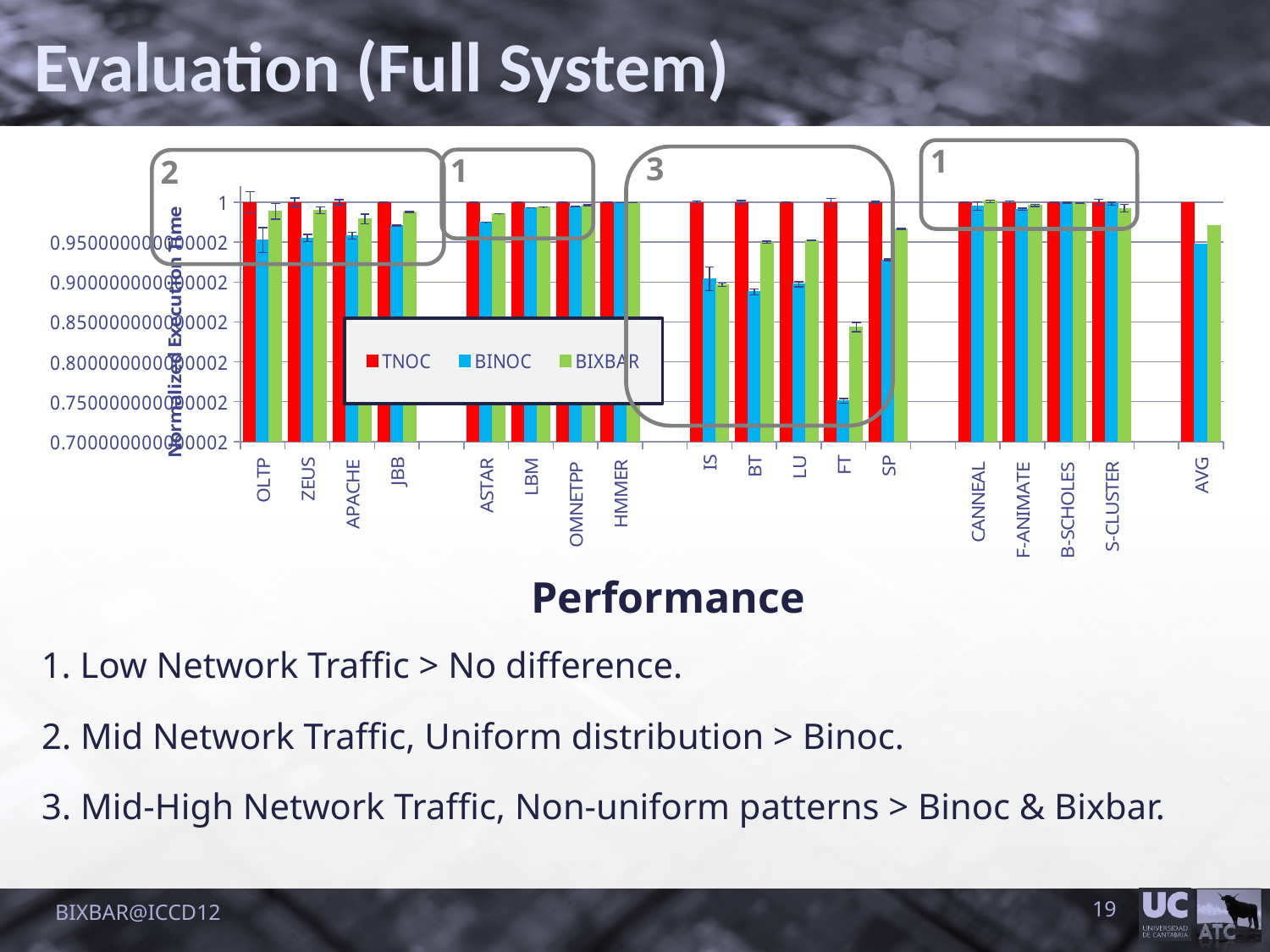
How many categories are shown along the x axis of the chart? 18 Which category has the lowest BINOC value? FT Is the BIXBAR value for FT greater or less than 0.9? less Is the BINOC value for SP greater or less than 0.95? less What is the title shown beneath the chart? Performance What are the three series named in the chart legend? TNOC, BINOC, BIXBAR What kind of chart is shown on the slide? bar chart How many series does the chart legend list? 3 Which category has the lowest BIXBAR value? FT Is the BINOC value for FT greater or less than 0.8? less For FT, which is larger: the BINOC value or the BIXBAR value? BIXBAR For SP, which is larger: the BINOC value or the BIXBAR value? BIXBAR